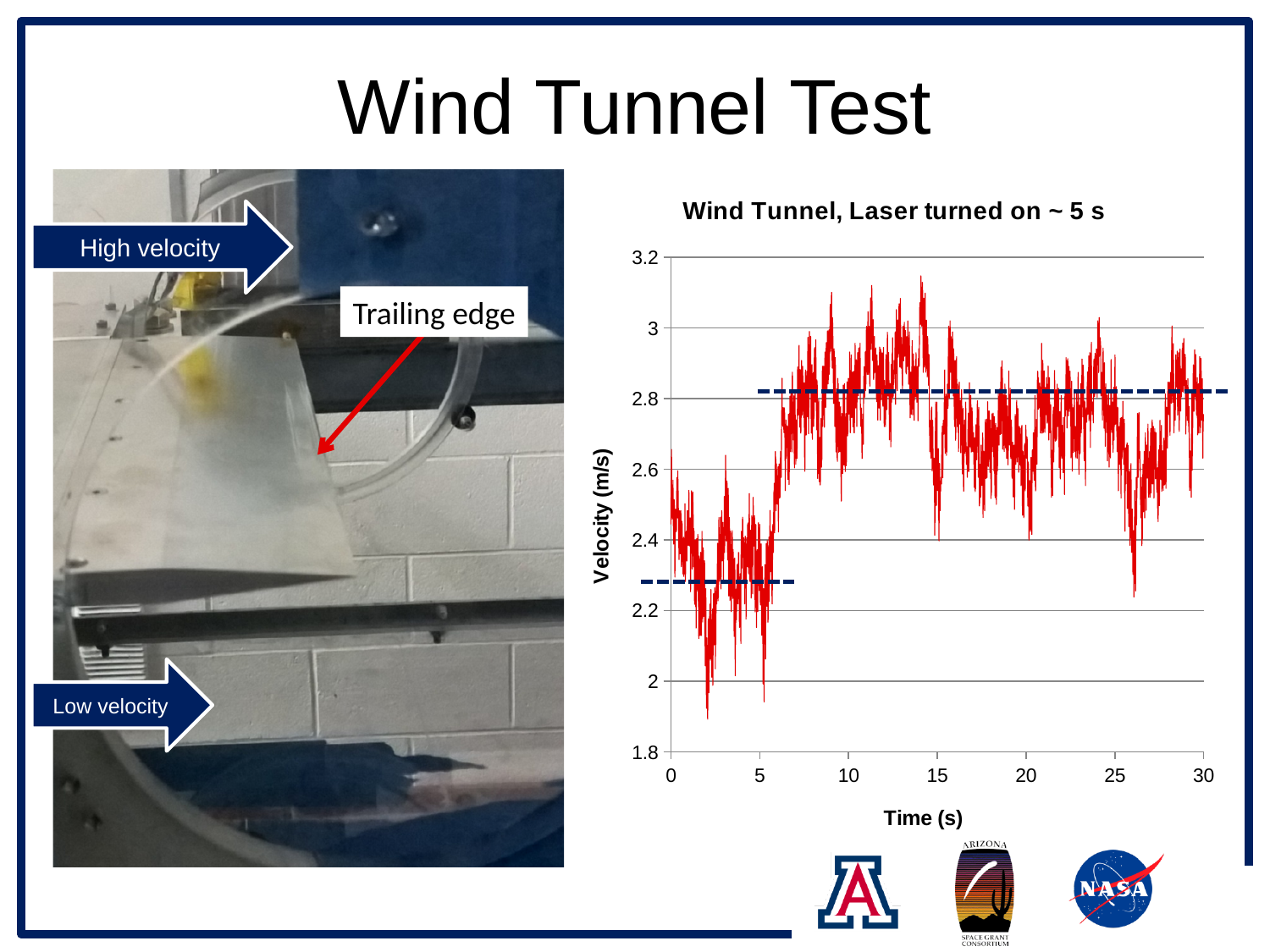
Is the velocity at 26 s greater or less than 2.8? less Does the velocity rise or fall after the laser is turned on at about 5 s? rise What is the label of the vertical axis of the chart? Velocity (m/s) Is the highest velocity reached in the chart greater or less than 3? greater Is the velocity at 2 s greater or less than 2.4? less What is the maximum value shown on the Time (s) axis? 30 What kind of chart is shown on the slide? line chart Which is larger, the velocity at 3 s or the velocity at 12 s? 12 s What is the title of the chart? Wind Tunnel, Laser turned on ~ 5 s